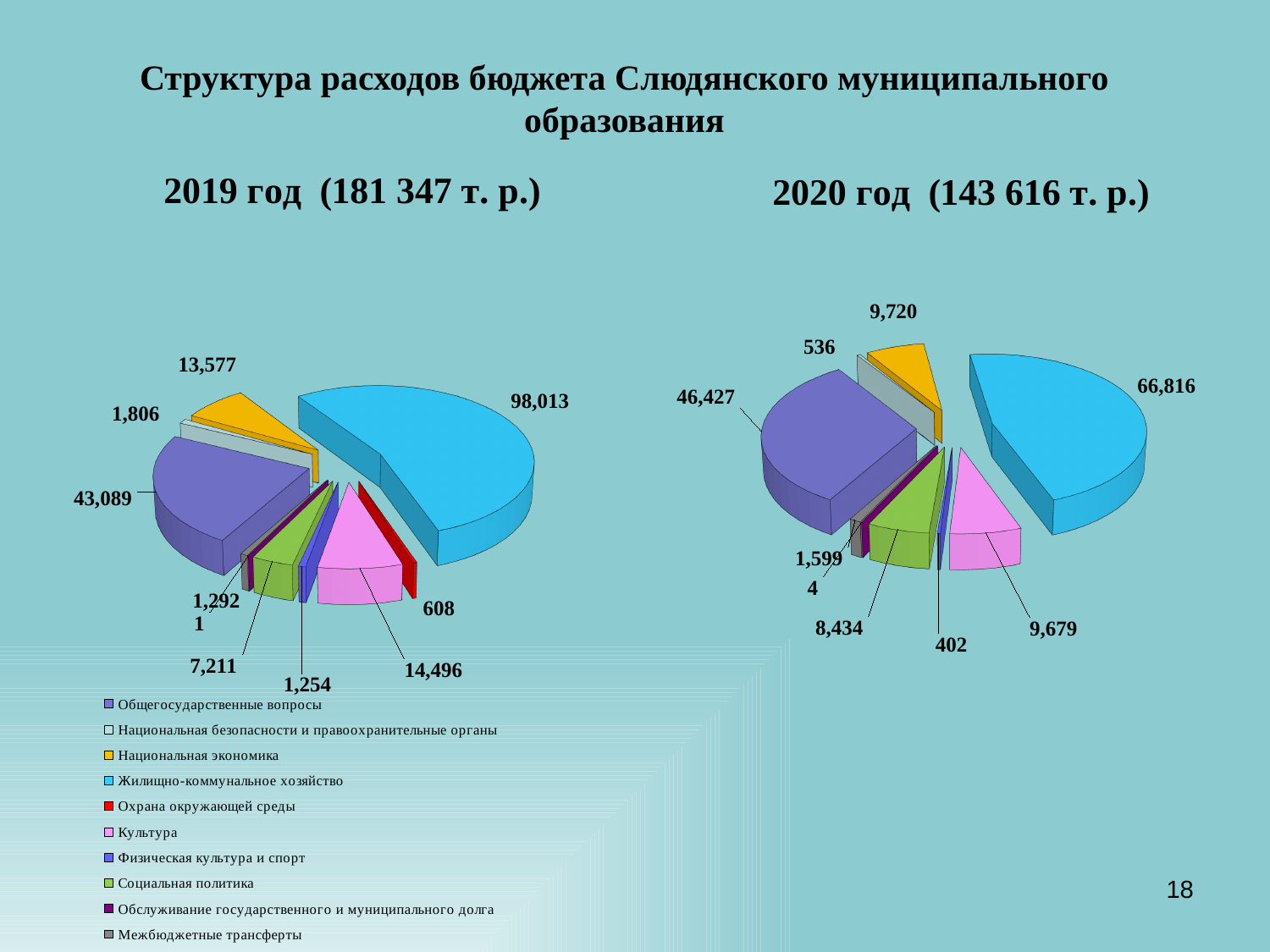
In the 2020 pie chart, what is the value for Национальная экономика? 9,720 What type of charts are shown on the slide? Pie charts In the 2019 pie chart, what is the value of the largest slice? 98,013 Which is larger: Культура in the 2019 pie chart or Культура in the 2020 pie chart? 2019 (14,496) What is the difference between the Общегосударственные вопросы values in the 2020 and 2019 pie charts? 3,338 In the 2019 pie chart, what is the value for Культура? 14,496 In the 2020 pie chart, what is the value for Общегосударственные вопросы? 46,427 In the 2019 pie chart, what is the value for Жилищно-коммунальное хозяйство? 98,013 What total budget expenditure is stated for 2020 in the chart heading? 143 616 т. р. In the 2019 pie chart, what is the value for Социальная политика? 7,211 How many categories does the legend list? 10 In the 2020 pie chart, what is the value of the largest slice? 66,816